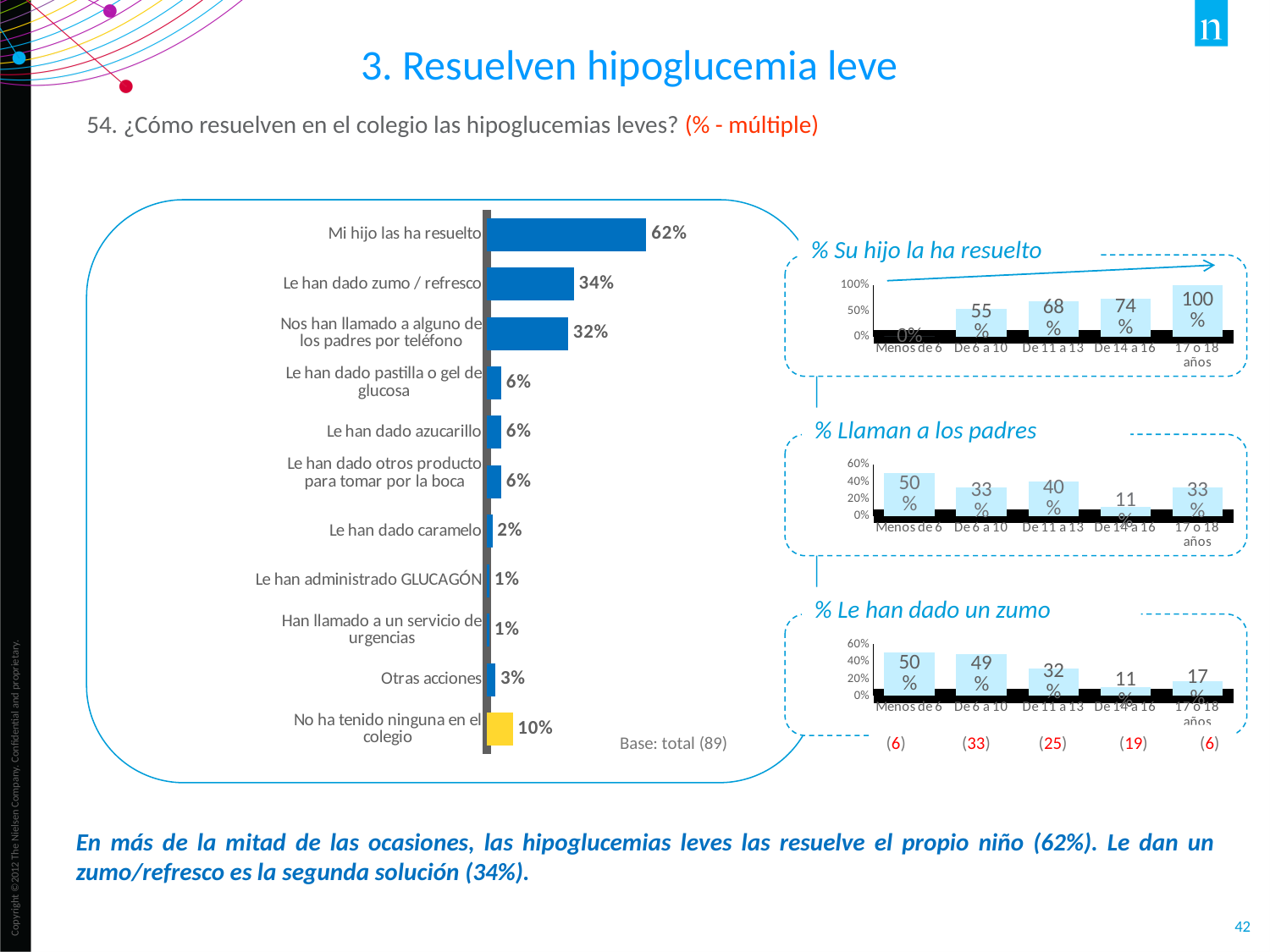
In the chart titled '% Su hijo la ha resuelto', what is the value for '17 o 18 años'? 100% In the large bar chart on the left, what is the value for 'Mi hijo las ha resuelto'? 62% In the chart titled '% Su hijo la ha resuelto', do the values rise or fall from 'Menos de 6' to '17 o 18 años'? Rise In the large bar chart on the left, what is the difference between 'Le han dado zumo / refresco' and 'Nos han llamado a alguno de los padres por teléfono'? 2% In the chart titled '% Llaman a los padres', which age group has the lowest value? De 14 a 16 In the large bar chart on the left, what is the value for 'Le han dado zumo / refresco'? 34% In the large bar chart on the left, what is the value for 'No ha tenido ninguna en el colegio'? 10% In the chart titled '% Le han dado un zumo', what is the value for 'De 6 a 10'? 49% In the chart titled '% Le han dado un zumo', which is larger: the value for 'De 11 a 13' or the value for '17 o 18 años'? De 11 a 13 In the large bar chart on the left, how many categories are shown? 11 In the large bar chart on the left, which category has the highest value? Mi hijo las ha resuelto What type of chart is the large chart on the left? Bar chart